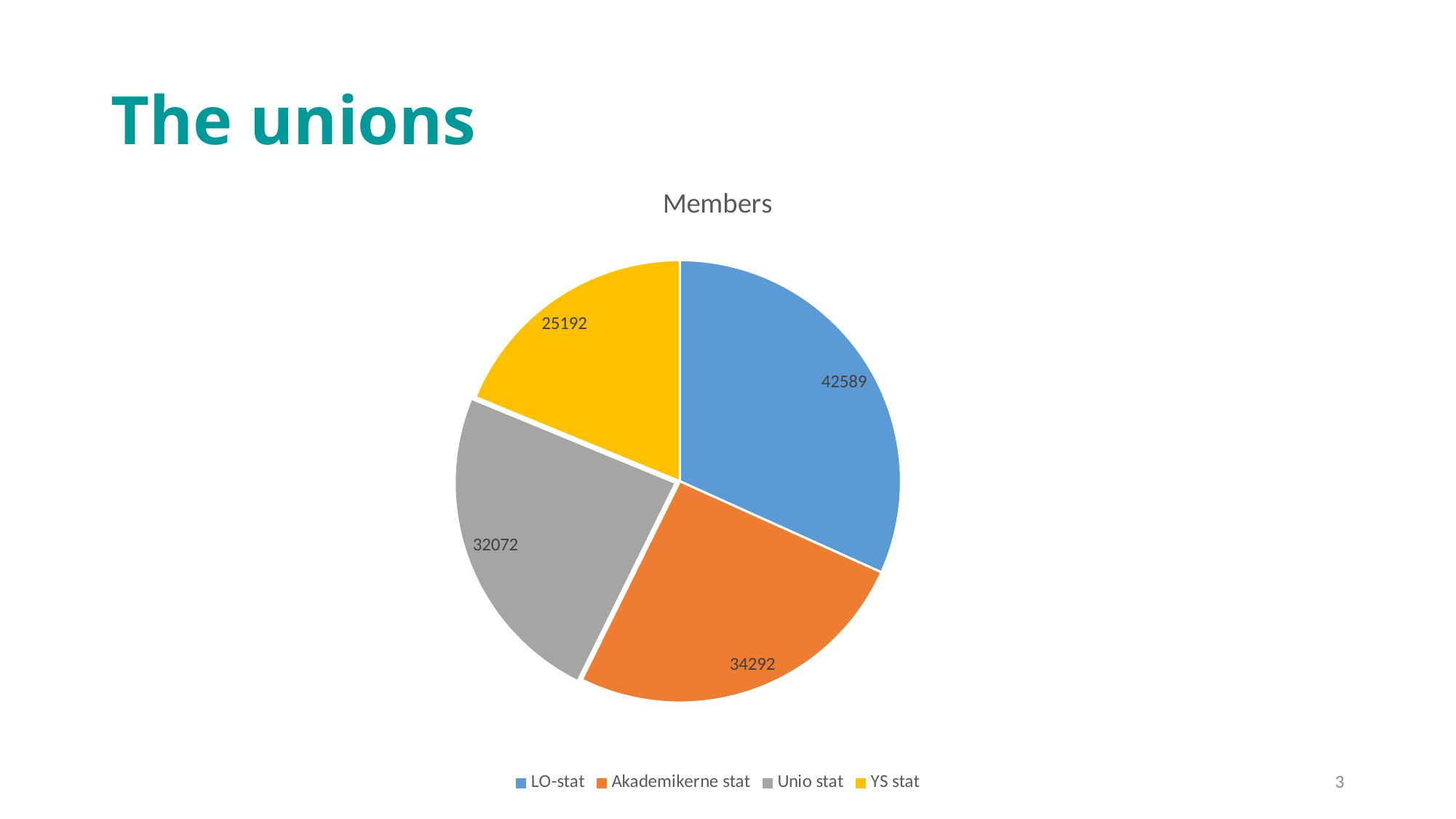
What type of chart is shown on the slide? pie chart Which colour represents Unio stat in the pie chart? grey What is the value for YS stat? 25192 How many slices does the pie chart have? 4 What is the difference between the values for LO-stat and Akademikerne stat? 8297 What is the value for Akademikerne stat? 34292 Which union has the smallest number of members? YS stat What is the title of the chart? Members What is the value for LO-stat? 42589 What is the value for Unio stat? 32072 Which union has the largest number of members? LO-stat Which is larger, the value for Akademikerne stat or the value for Unio stat? Akademikerne stat